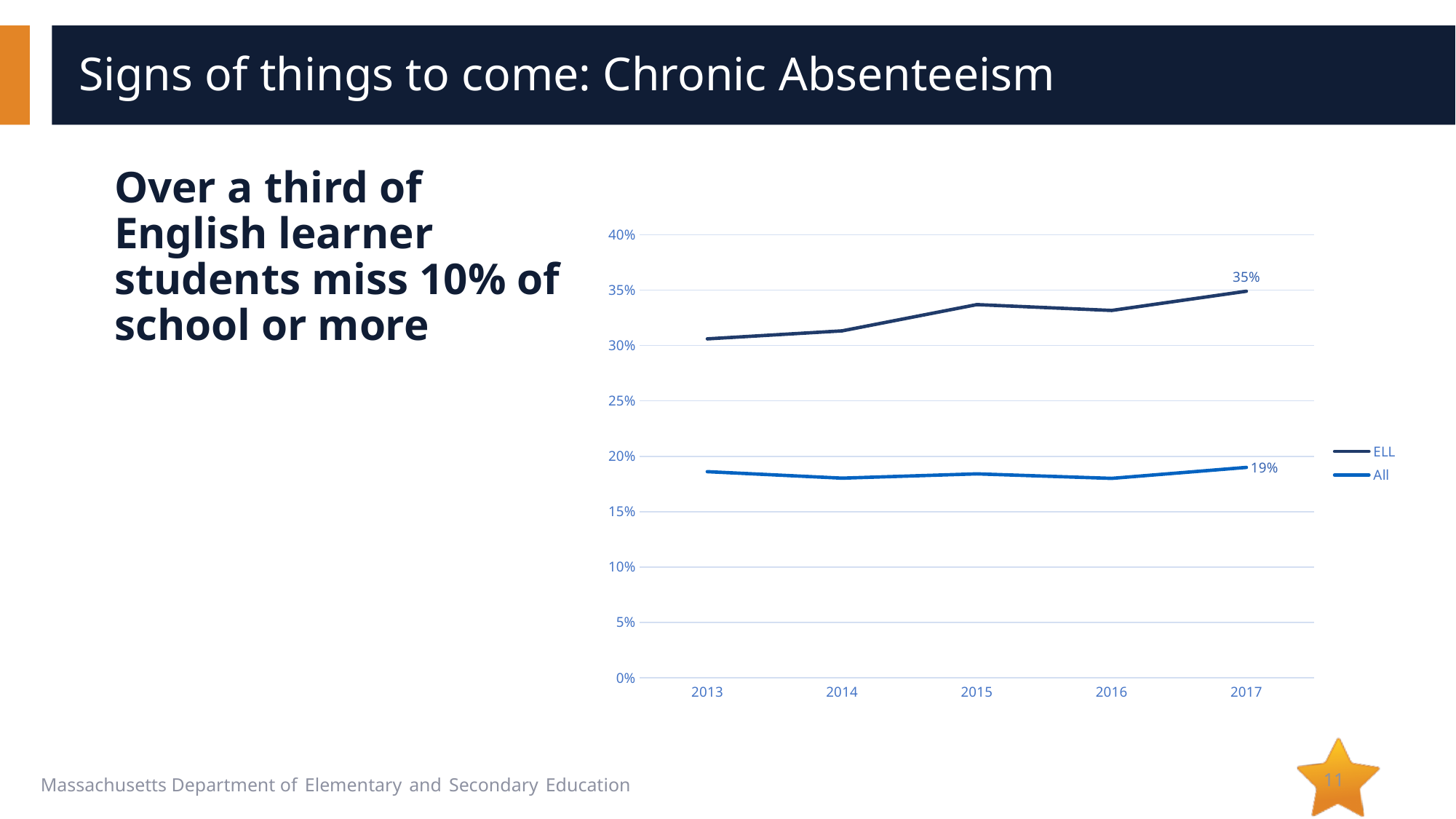
What is the difference between the ELL and All values in 2017? 16% Does the ELL line generally rise or fall from 2013 to 2017? Rise How many series does the legend list? 2 What is the value for ELL in 2017? 35% Which series has the higher value in 2017, ELL or All? ELL What kind of chart is shown on the slide? Line chart How many years are shown on the x axis? 5 Is the value for ELL in 2013 greater or less than 30%? greater Is the value for All in 2014 greater or less than 20%? less What is the value for All in 2017? 19% Is the value for ELL in 2015 greater or less than 35%? less What are the two series named in the legend? ELL and All